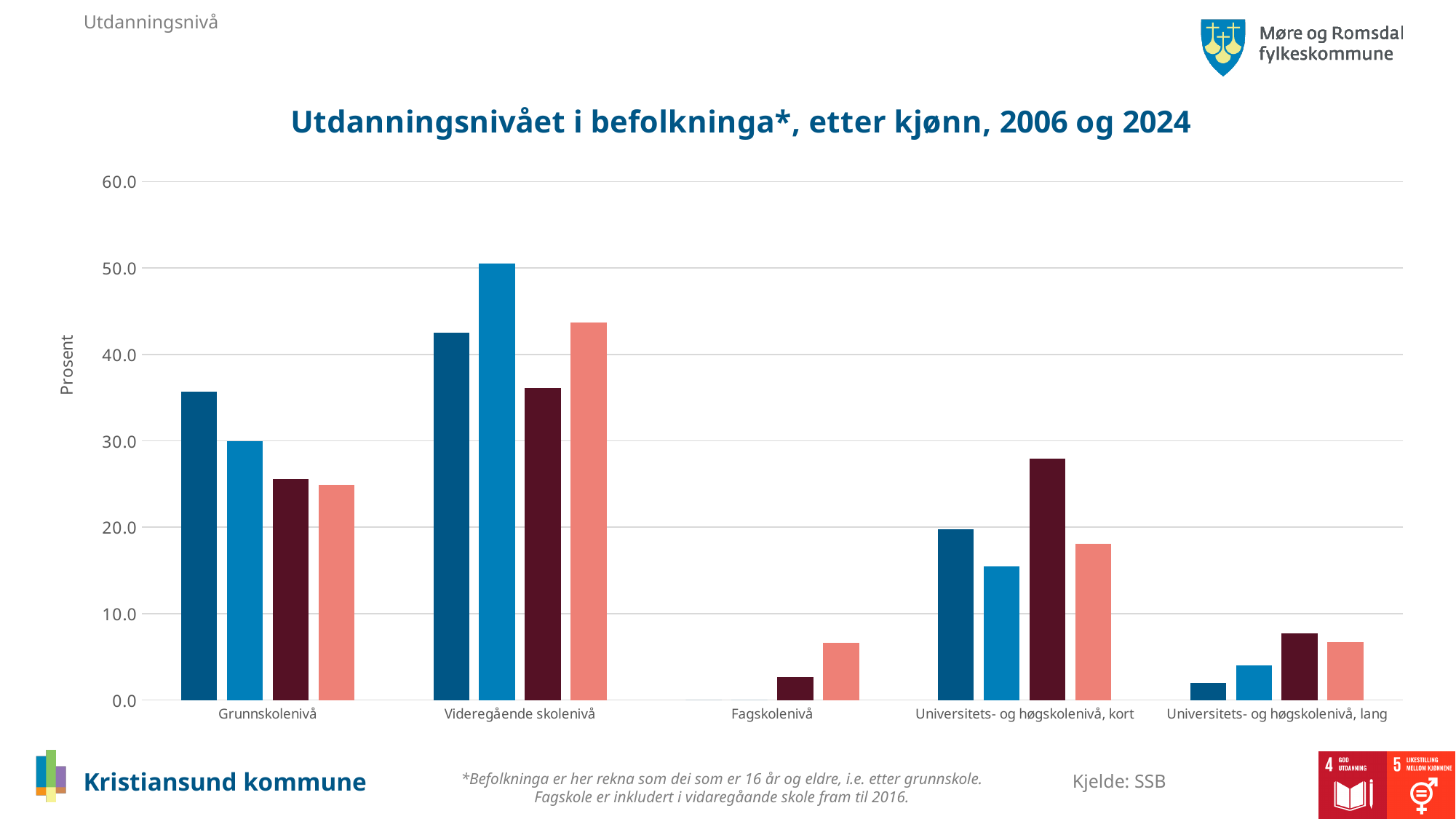
Is the value of the dark red bar for Universitets- og høgskolenivå, kort greater or less than 30? less How many bars are plotted for the Grunnskolenivå category? 4 What is the title of the chart? Utdanningsnivået i befolkninga*, etter kjønn, 2006 og 2024 How many categories are shown on the x axis of the chart? 5 Is the value of the last (salmon) bar for Videregående skolenivå greater or less than 40? greater What is the label of the vertical axis? Prosent Is the value of the first (dark blue) bar for Grunnskolenivå greater or less than 30? greater What kind of chart is shown on the slide? bar chart Which is larger: the first (dark blue) bar for Grunnskolenivå or the first (dark blue) bar for Videregående skolenivå? Videregående skolenivå Which category contains the tallest bar in the chart? Videregående skolenivå How many bars are plotted for the Fagskolenivå category? 2